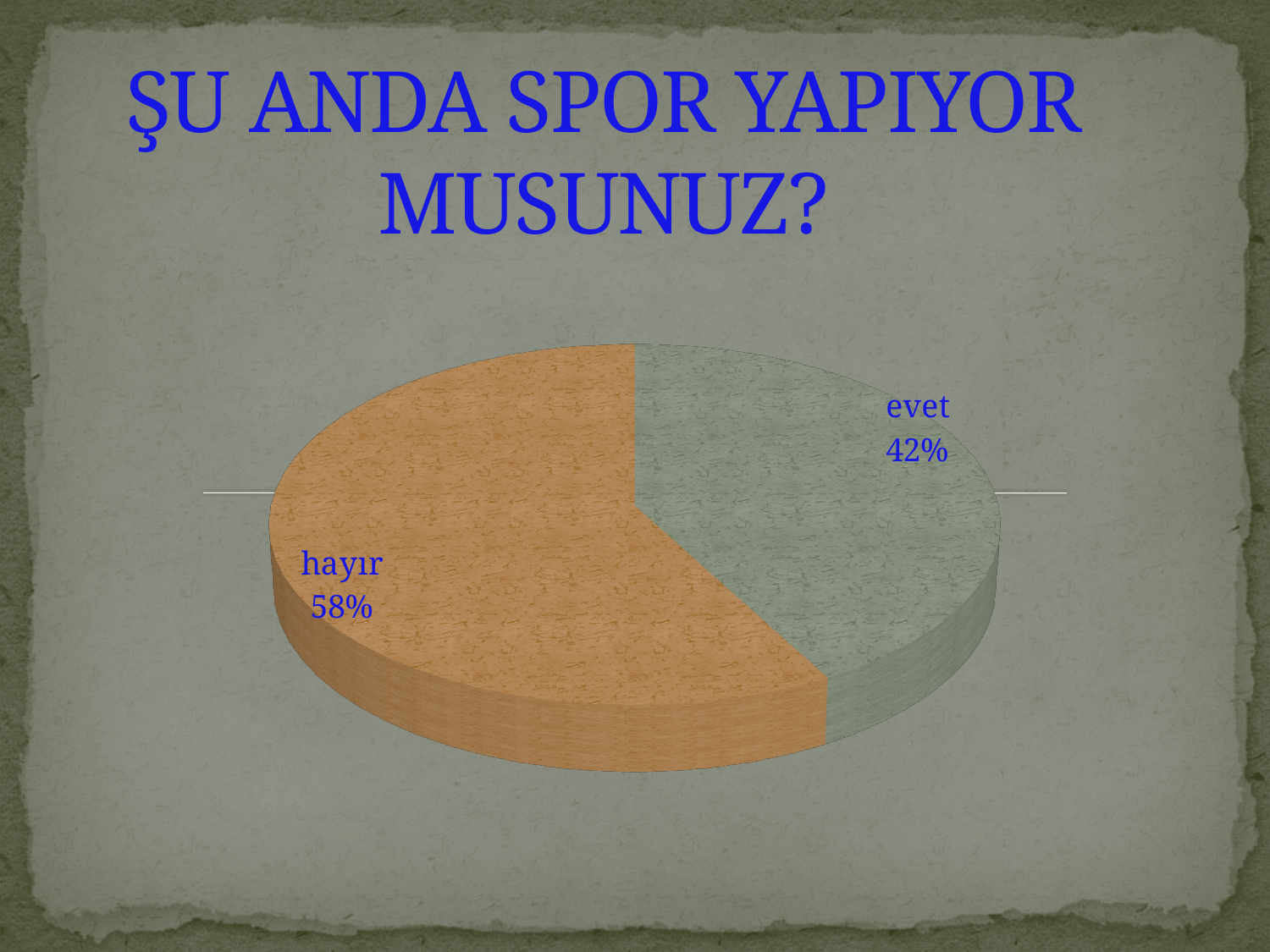
What is the difference in percentage points between the "hayır" slice and the "evet" slice? 16 How many slices does the pie chart have? 2 What percentage of the pie chart is labelled "hayır"? 58% What share of the pie does the "evet" slice represent? 42% What colour is the "hayır" slice of the pie chart? orange What is the title of the slide containing the pie chart? ŞU ANDA SPOR YAPIYOR MUSUNUZ? Which slice of the pie chart is the largest? hayır Which slice of the pie chart is the smallest? evet What kind of chart is shown on the slide? pie chart Which is larger, the "evet" slice or the "hayır" slice? hayır What percentage of the pie chart is labelled "evet"? 42%